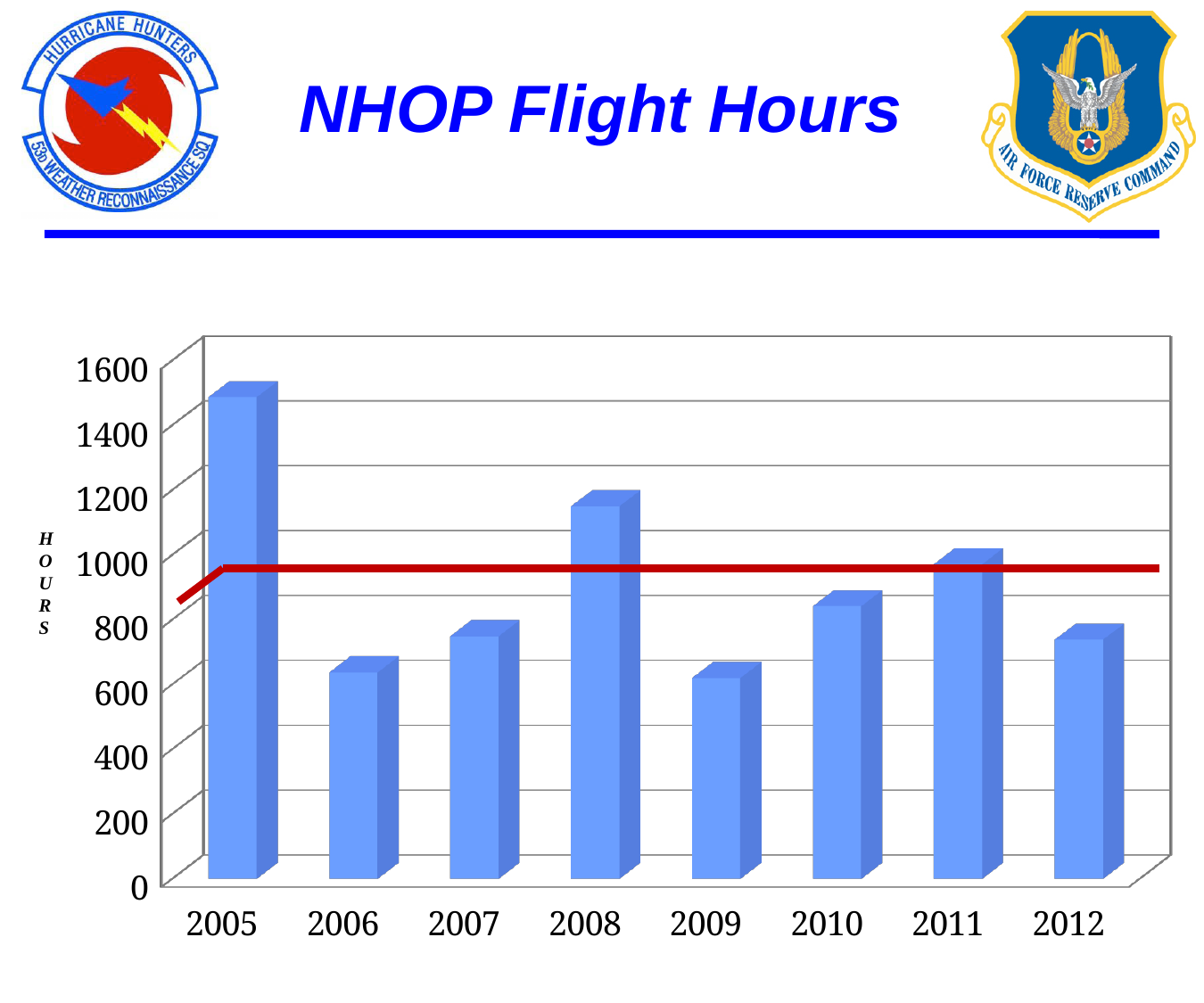
Is the value for 2008 greater or less than 1000? greater What is the title of the chart? NHOP Flight Hours Is the value for 2005 greater or less than 1400? greater Which year has more flight hours, 2008 or 2011? 2008 Is the value for 2009 greater or less than 800? less Which year has the highest flight hours? 2005 How many years are shown on the x axis of the chart? 8 What kind of chart is shown on the slide? bar chart What label is shown on the vertical axis of the chart? HOURS